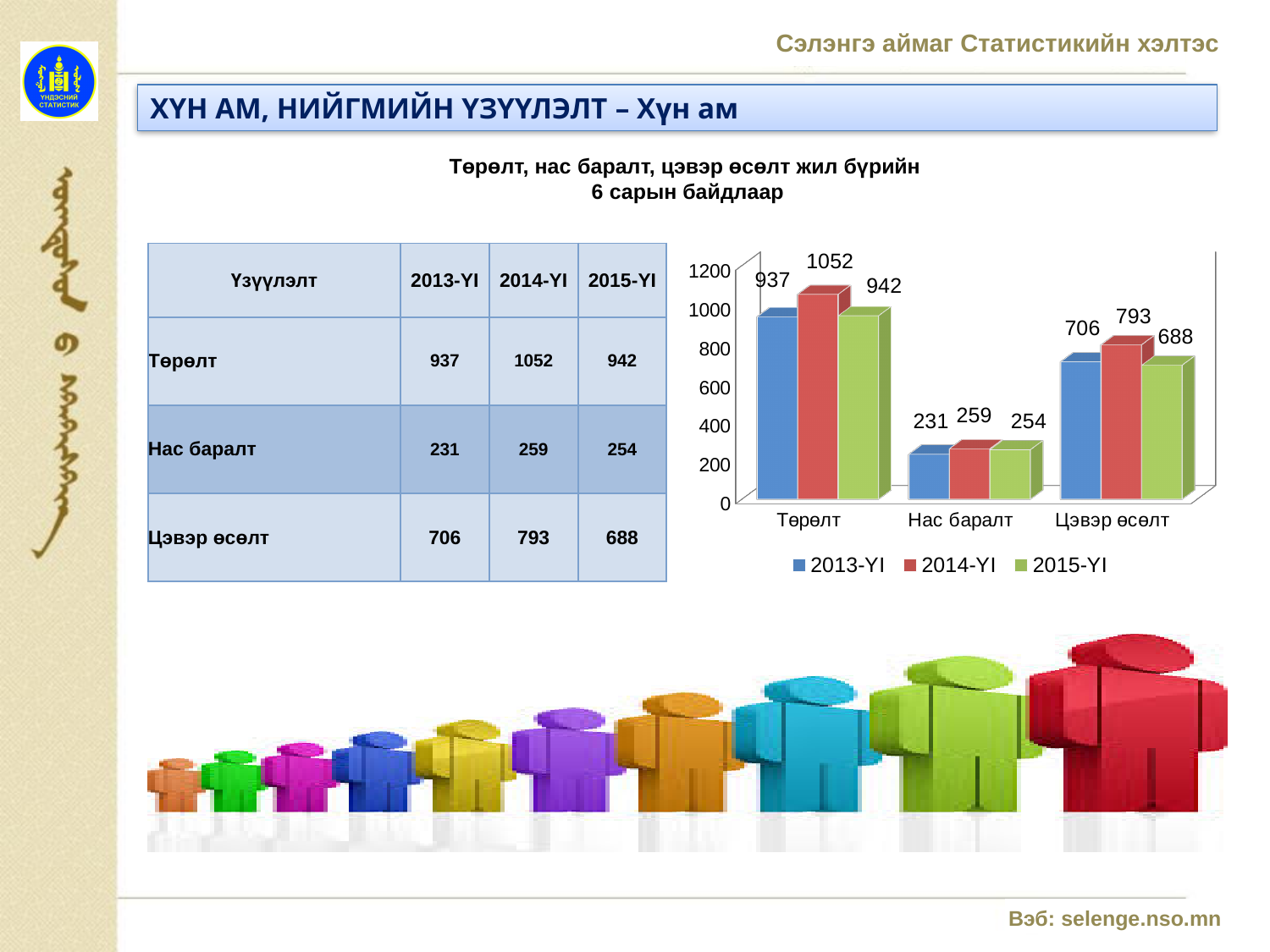
Which category has the highest value in the 2014-YI series? Төрөлт What is the value for Нас баралт in the 2013-YI series? 231 How many series does the legend list? 3 What is the difference between the 2014-YI and 2013-YI values for Төрөлт? 115 Which category has the lowest value in the 2015-YI series? Нас баралт Is the value for Нас баралт in 2014-YI greater or less than 400? less What is the value for Төрөлт in the 2014-YI series? 1052 Which colour represents the 2015-YI series in the chart? green How many categories are shown on the x axis of the chart? 3 What is the value for Цэвэр өсөлт in the 2015-YI series? 688 Which is larger for Цэвэр өсөлт: the 2013-YI value or the 2015-YI value? 2013-YI What kind of chart is shown on the slide? bar chart